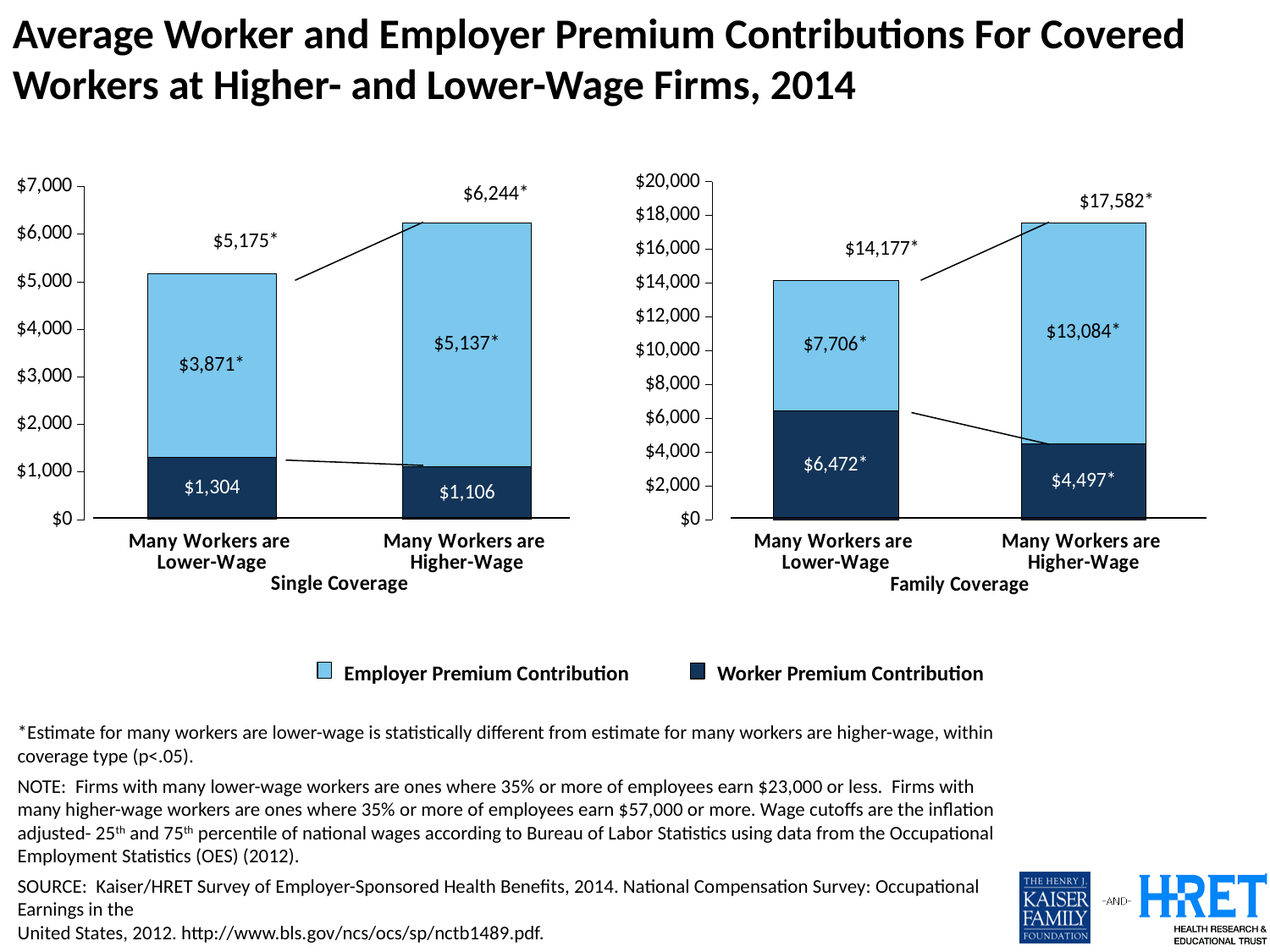
In the Single Coverage chart, what is the difference between the Worker Premium Contribution at lower-wage firms and at higher-wage firms? $198 In the Family Coverage chart, what is the difference between the total premiums for higher-wage and lower-wage firms? $3,405 In the Single Coverage chart, what is the Worker Premium Contribution for firms where many workers are higher-wage? $1,106 In the Family Coverage chart, what is the Worker Premium Contribution for firms where many workers are lower-wage? $6,472 How many series does the legend list? 2 In the Family Coverage chart, what is the total premium for firms where many workers are lower-wage? $14,177 In the Single Coverage chart, what is the Employer Premium Contribution for firms where many workers are lower-wage? $3,871 What kind of chart is the Family Coverage chart? Stacked bar chart In the Family Coverage chart, which category has the larger Worker Premium Contribution, lower-wage firms or higher-wage firms? Many Workers are Lower-Wage In the Family Coverage chart, what is the Employer Premium Contribution for firms where many workers are higher-wage? $13,084 In the Single Coverage chart, is the total premium for lower-wage firms greater or less than $5,000? greater In the Single Coverage chart, what is the total premium for firms where many workers are higher-wage? $6,244